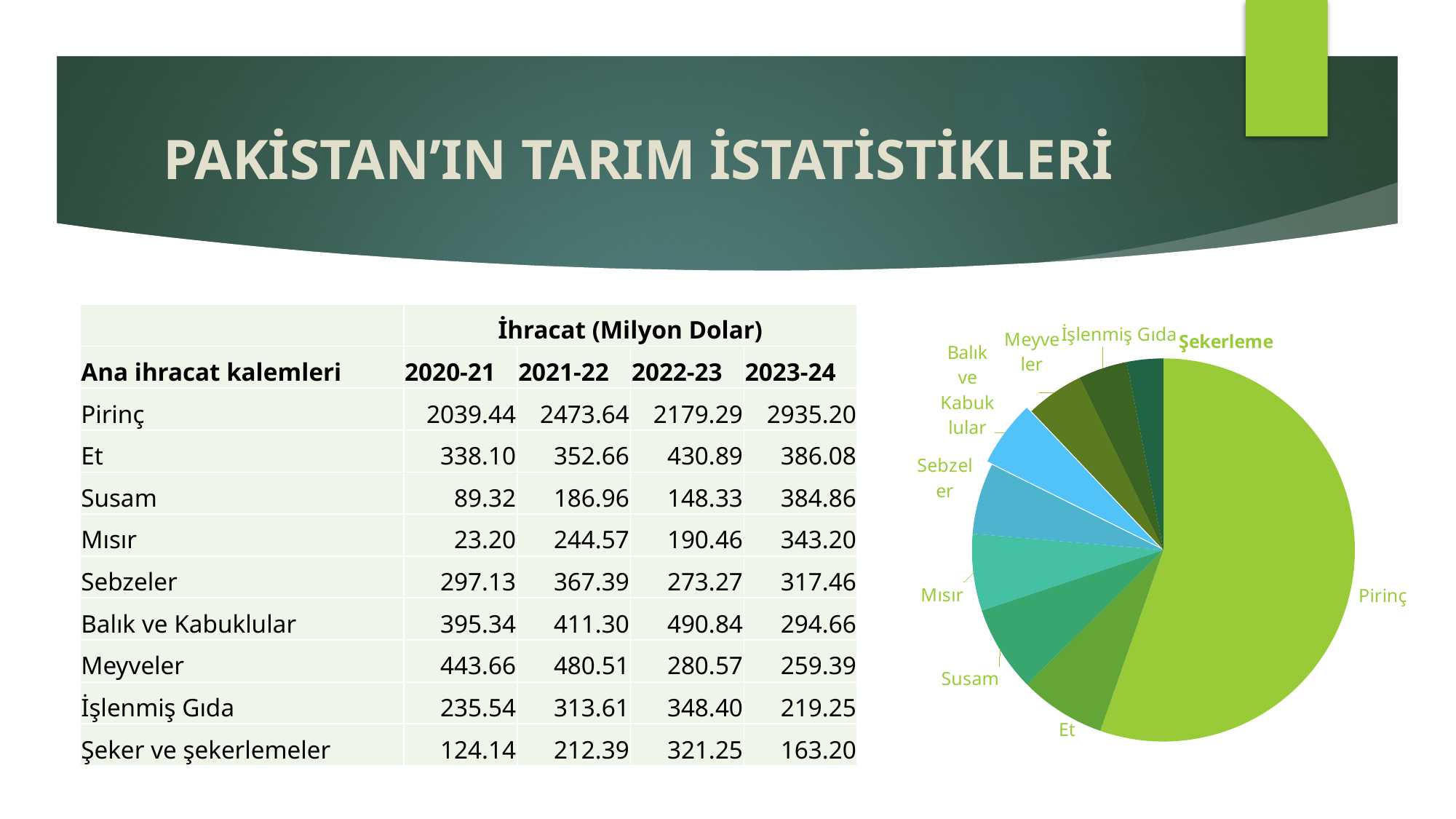
In the pie chart, which slice is larger, Et or Meyveler? Et In the pie chart, which slice is larger, Pirinç or Susam? Pirinç How many slices does the pie chart have? 9 In the pie chart, which slice is larger, Susam or Şekerleme? Susam Which category has the largest slice in the pie chart? Pirinç Does the pie chart have a legend? No Which slice label in the pie chart is written in bold? Şekerleme What kind of chart is shown on the right side of the slide? pie chart